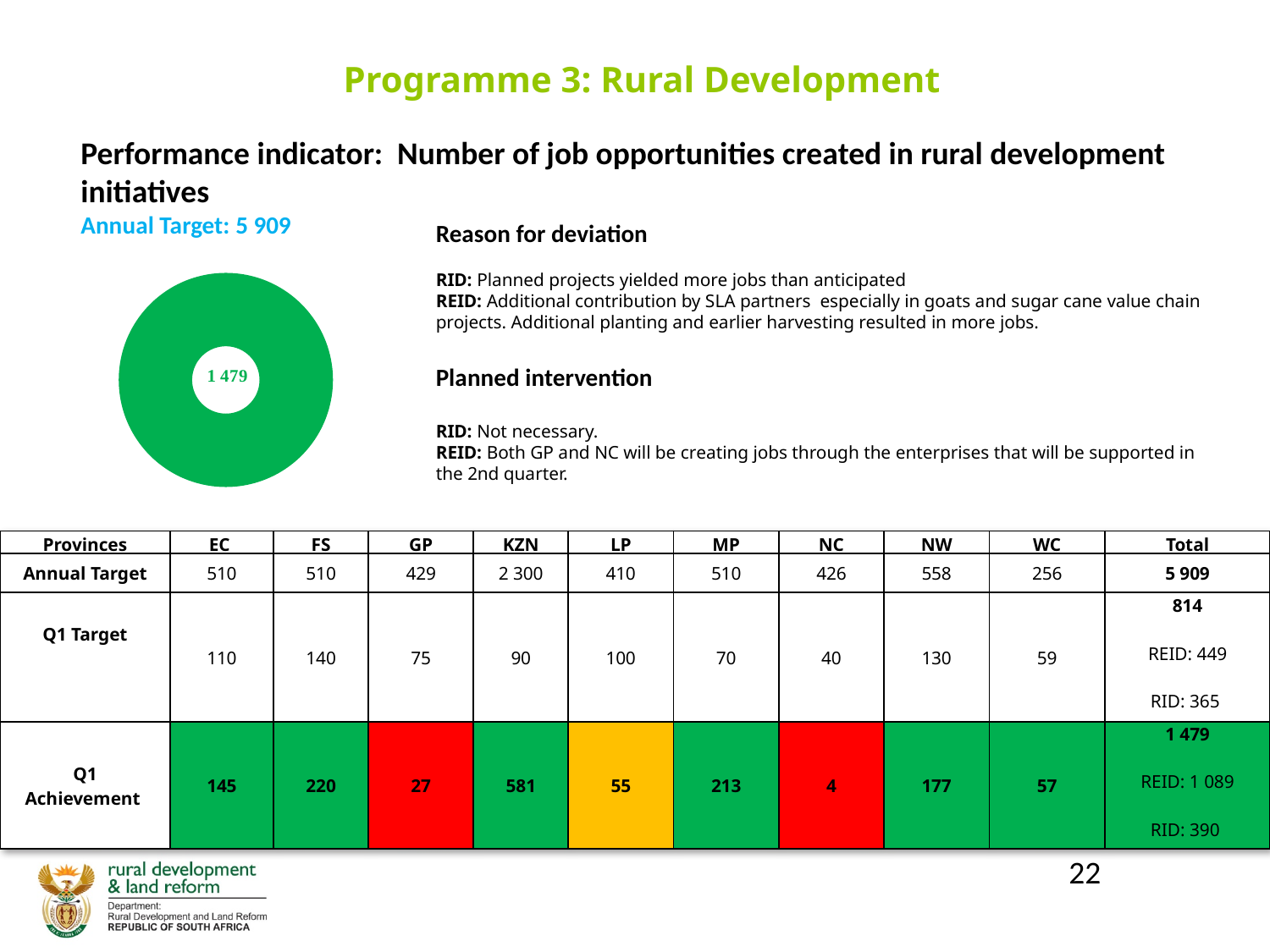
What colour is the ring of the doughnut chart? green Is the value shown in the centre of the doughnut chart greater or less than 1 000? greater What value is printed in the centre of the doughnut chart? 1 479 Does the doughnut chart display a legend? No What kind of chart is shown on the left of the slide? doughnut chart How many distinct segments are visible in the doughnut chart? 1